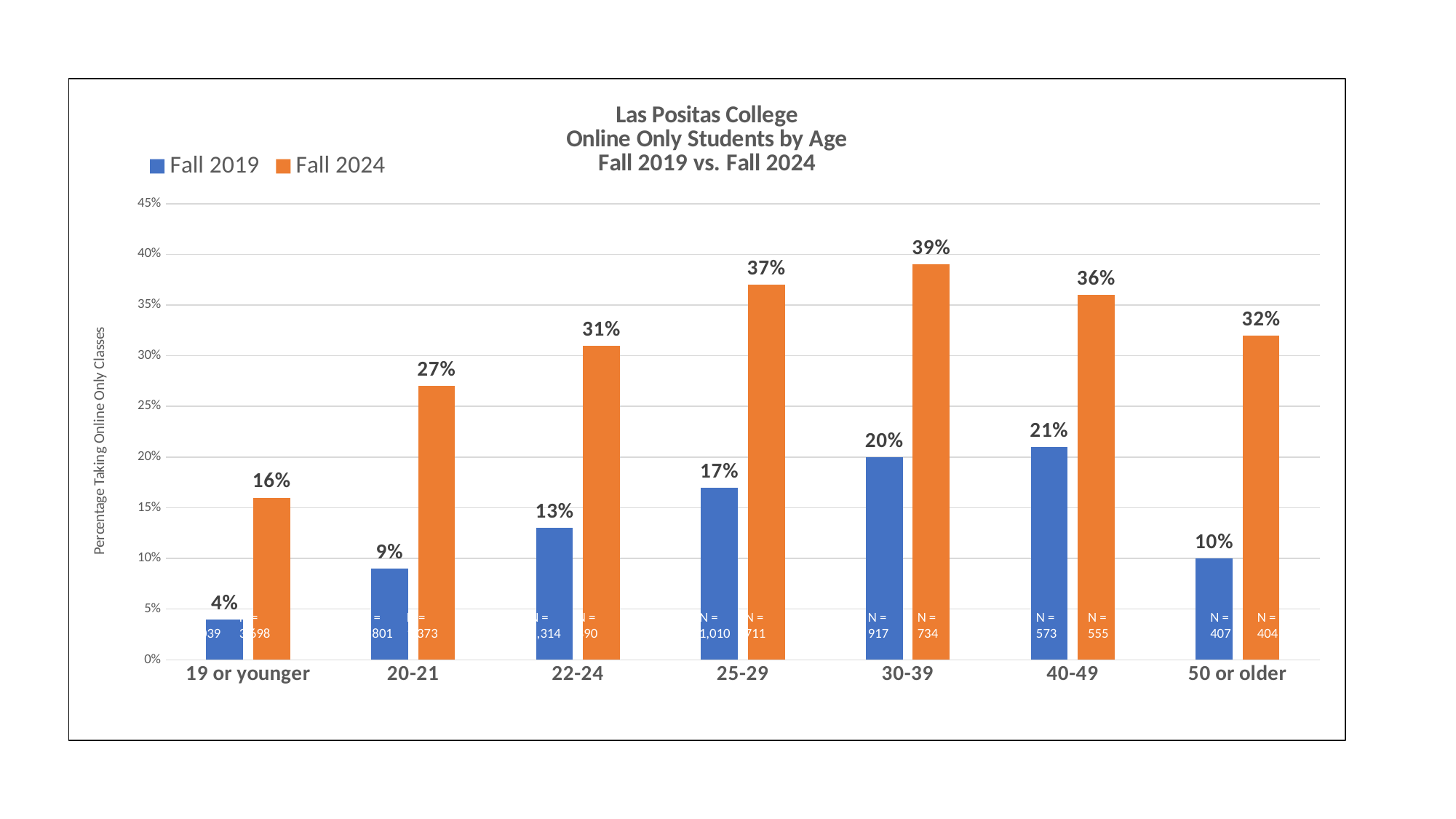
How many series does the legend list? 2 Which age group has the lowest Fall 2019 value? 19 or younger What kind of chart is shown on the slide? Bar chart How many age groups are shown on the x axis? 7 Which is larger for the 50 or older age group, the Fall 2019 value or the Fall 2024 value? Fall 2024 Which series is shown in orange? Fall 2024 What is the Fall 2024 value for the 30-39 age group? 39% What is the Fall 2019 value for the 19 or younger age group? 4% What is the difference between the Fall 2024 and Fall 2019 values for the 25-29 age group? 20 percentage points What is the label on the vertical axis? Percentage Taking Online Only Classes Which age group has the highest Fall 2024 value? 30-39 What is the Fall 2019 value for the 40-49 age group? 21%